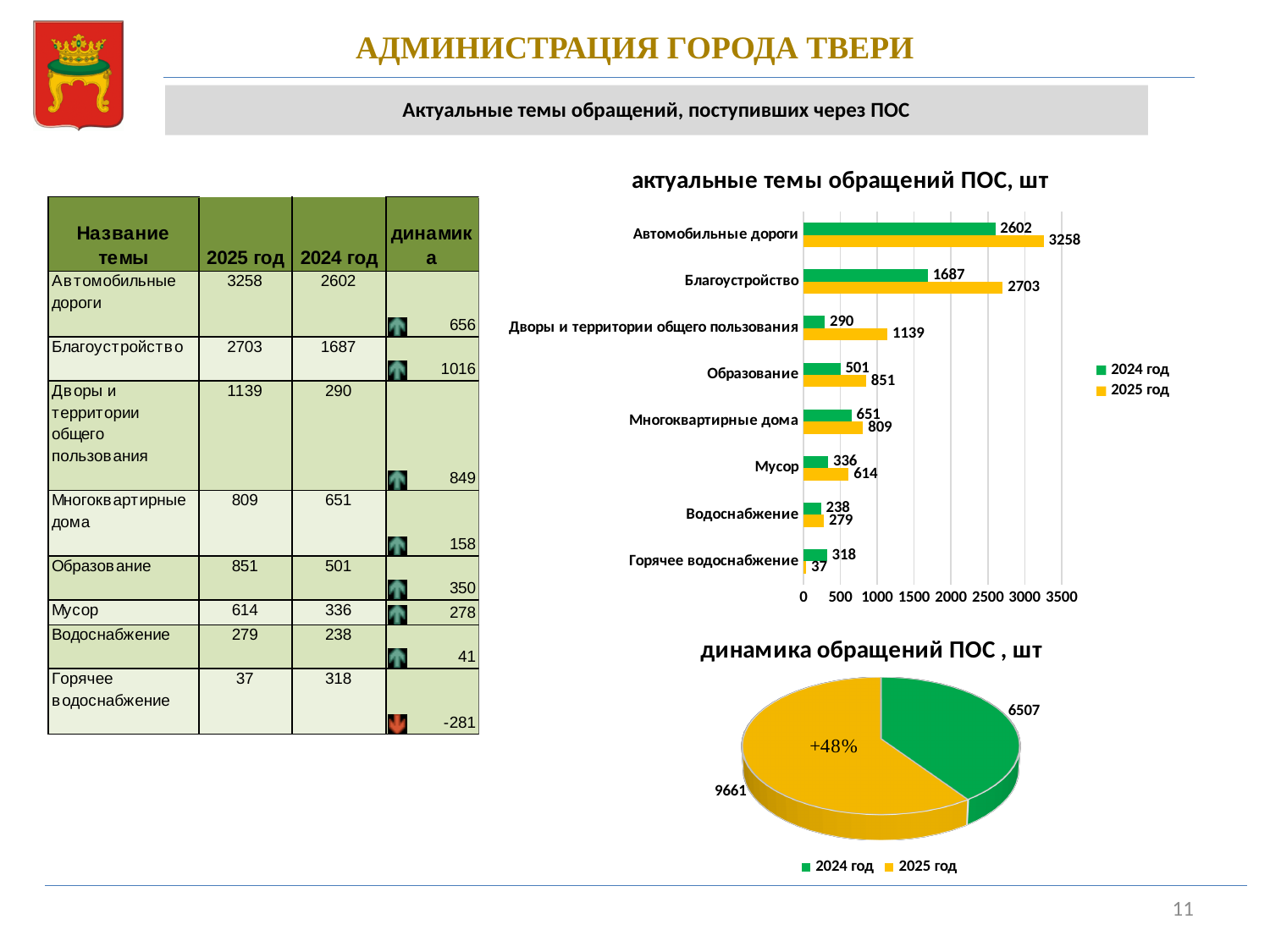
What kind of chart is the chart titled "актуальные темы обращений ПОС, шт"? bar chart In the chart "актуальные темы обращений ПОС, шт", what is the difference between the 2025 год and 2024 год values for Автомобильные дороги? 656 In the chart "актуальные темы обращений ПОС, шт", which category has the lowest value for 2025 год? Горячее водоснабжение In the chart "динамика обращений ПОС , шт", what is the difference between the 2025 год and 2024 год values? 3154 In the chart "динамика обращений ПОС , шт", what is the value for 2025 год? 9661 In the chart "актуальные темы обращений ПОС, шт", how many series does the legend list? 2 In the chart "актуальные темы обращений ПОС, шт", how many categories are shown? 8 In the chart "актуальные темы обращений ПОС, шт", what is the value for Горячее водоснабжение in 2024 год? 318 In the chart "актуальные темы обращений ПОС, шт", which category has the highest value for 2025 год? Автомобильные дороги In the chart "актуальные темы обращений ПОС, шт", what is the value for Благоустройство in 2025 год? 2703 In the chart "актуальные темы обращений ПОС, шт", which is larger for 2025 год: Образование or Многоквартирные дома? Образование What kind of chart is the chart titled "динамика обращений ПОС , шт"? pie chart